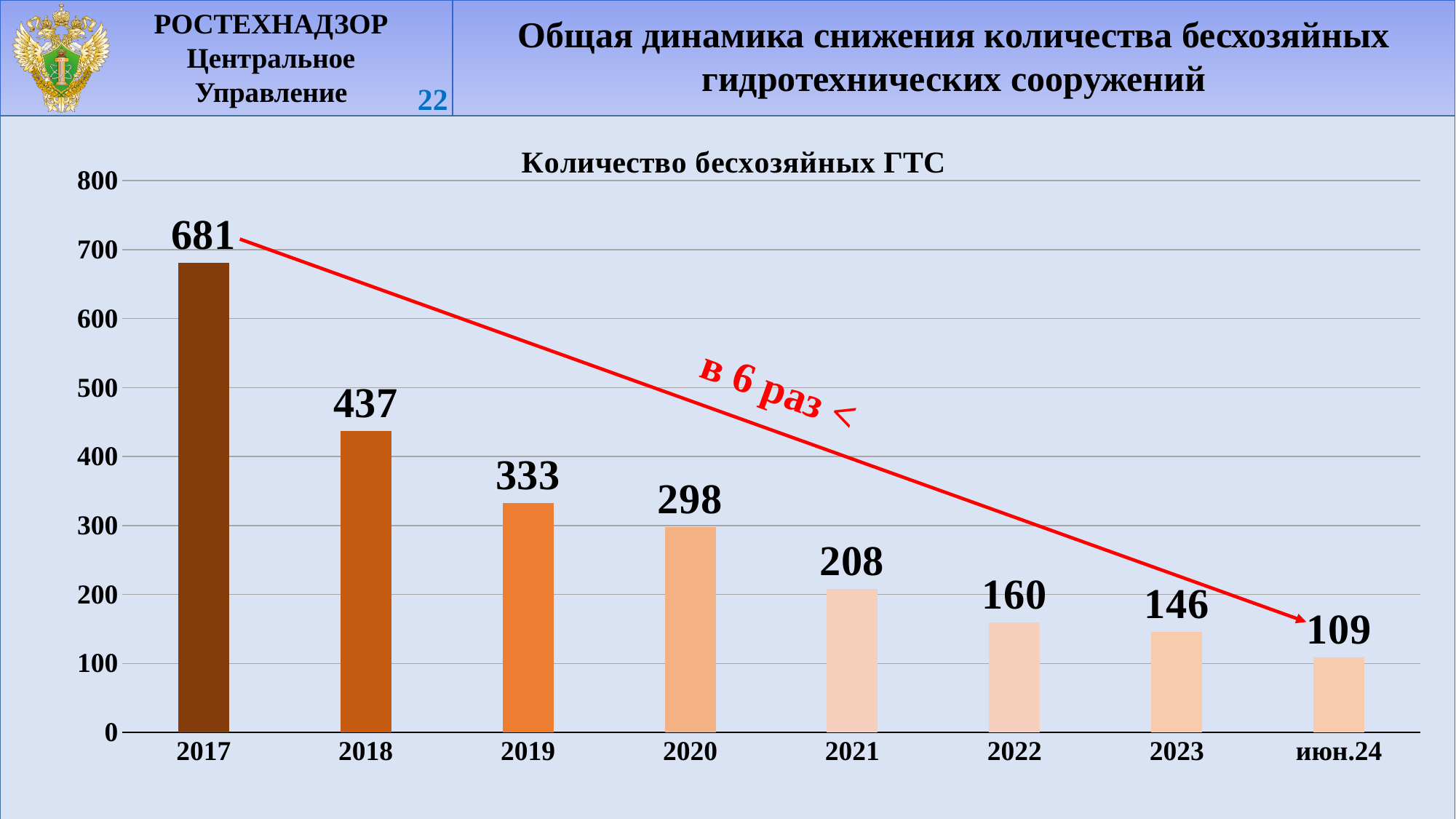
What kind of chart is shown? bar chart What is the difference between the values for 2022 and 2023? 14 What is the difference between the values for 2017 and 2018? 244 What is the value for июн.24? 109 Which category has the lowest value? июн.24 Which category has the highest value? 2017 What is the value for 2017? 681 Is the value for 2018 greater or less than 400? greater Which is larger, the value for 2019 or the value for 2021? 2019 Do the values rise or fall from 2017 to июн.24? fall What is the value for 2020? 298 How many categories are shown on the x axis? 8